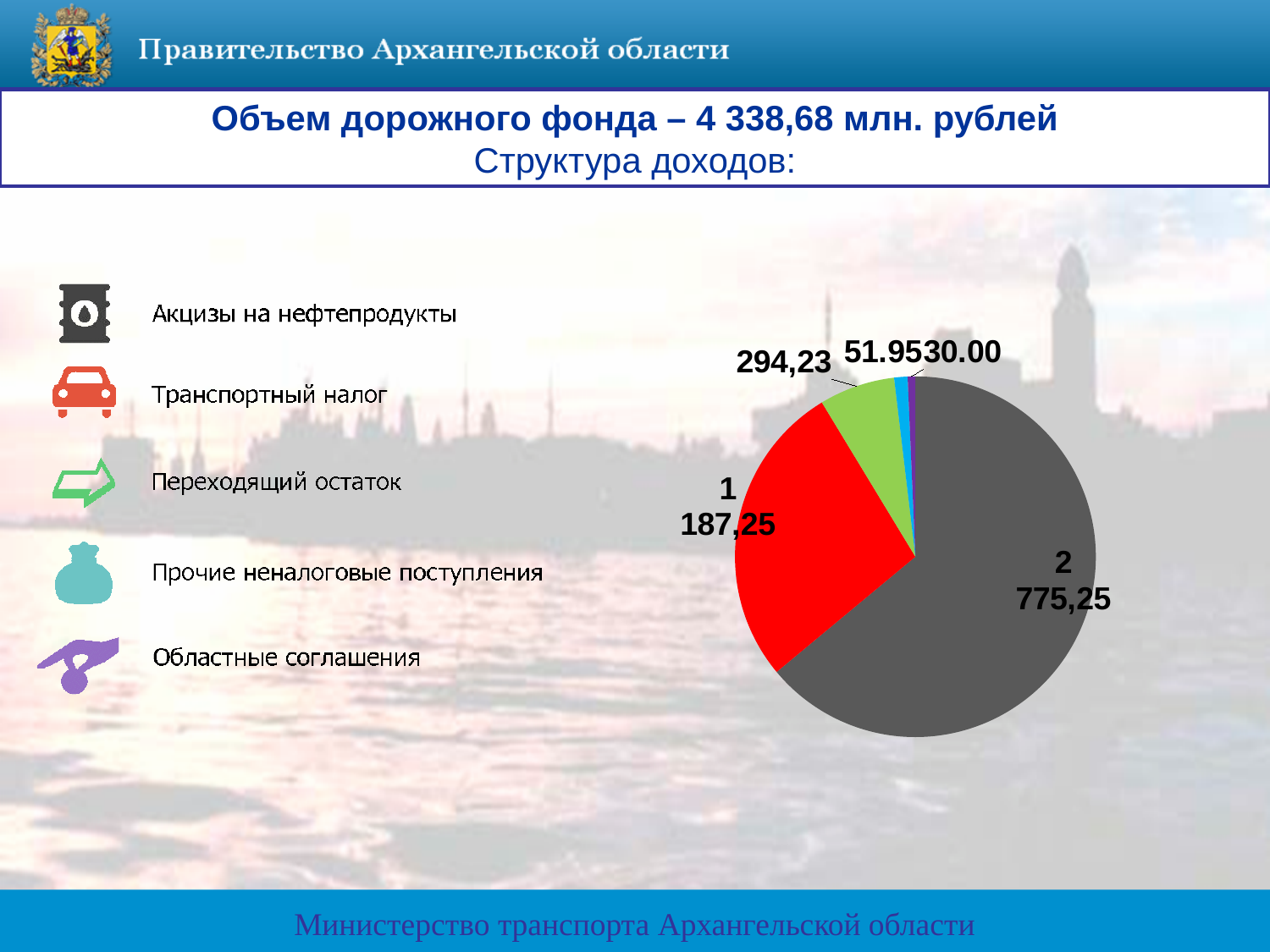
What is the value shown for Прочие неналоговые поступления (the blue slice)? 51.95 Which category has the smallest slice of the pie? Областные соглашения What total volume of the road fund is stated in the slide title? 4 338,68 млн. рублей What is the difference between the values for Акцизы на нефтепродукты and Транспортный налог? 1 588,00 What is the value shown for Акцизы на нефтепродукты (the grey slice)? 2 775,25 What kind of chart is shown on the slide? pie chart What colour is the slice for Транспортный налог? red What is the value shown for Транспортный налог (the red slice)? 1 187,25 How many slices does the pie chart have? 5 What is the value shown for Переходящий остаток (the green slice)? 294,23 Which is larger, Транспортный налог or Переходящий остаток? Транспортный налог Which category has the largest slice of the pie? Акцизы на нефтепродукты